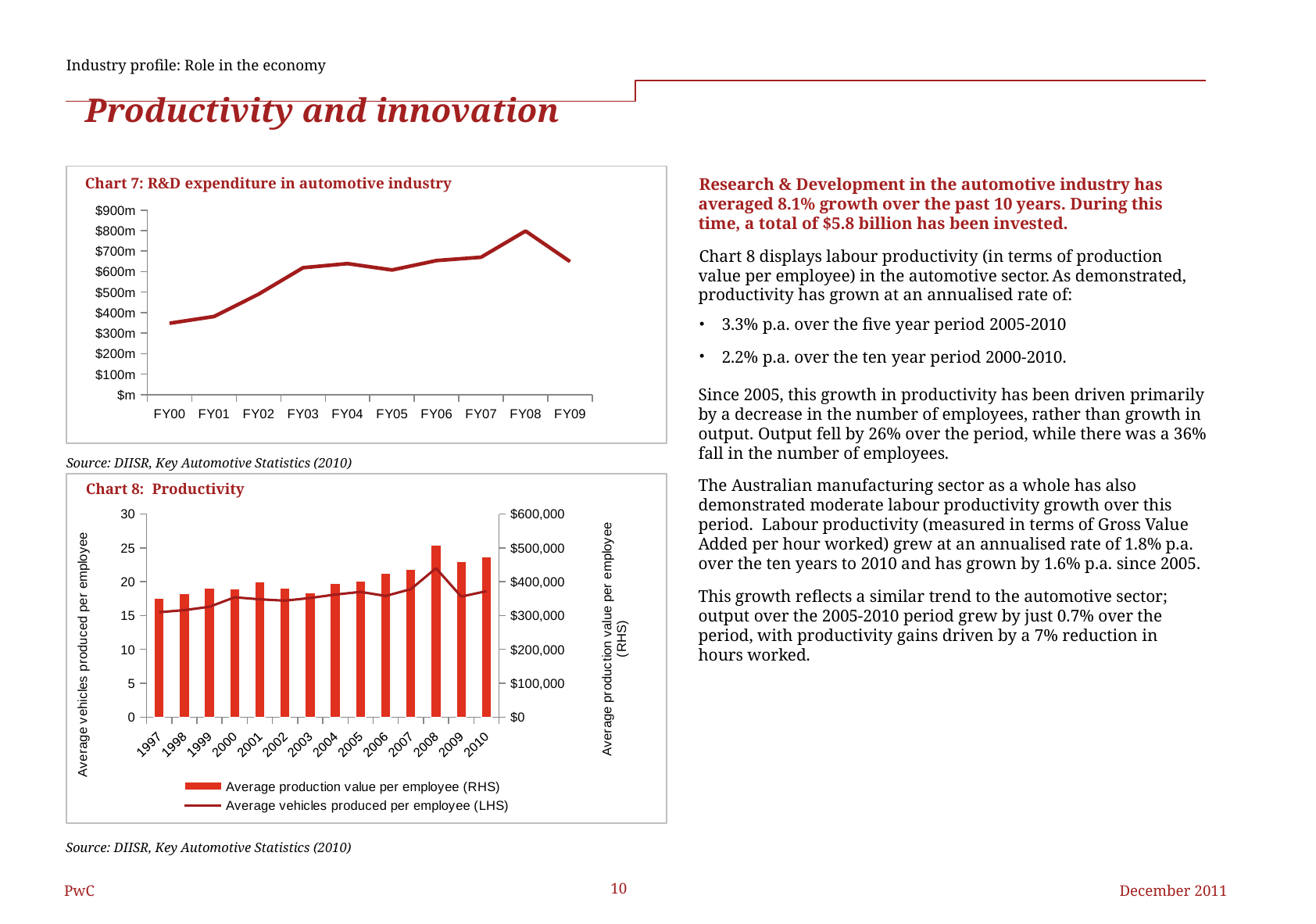
In Chart 7: R&D expenditure in automotive industry, is the value for FY00 greater or less than $400m? less In Chart 7: R&D expenditure in automotive industry, which fiscal year has the highest R&D expenditure? FY08 In Chart 8: Productivity, which year has the highest average production value per employee? 2008 In Chart 8: Productivity, how many series does the legend list? 2 In Chart 8: Productivity, how many years are shown on the x axis? 14 In Chart 7: R&D expenditure in automotive industry, is the value for FY08 greater or less than $700m? greater In Chart 7: R&D expenditure in automotive industry, how many fiscal years are plotted? 10 What kind of chart is Chart 7: R&D expenditure in automotive industry? line chart In Chart 8: Productivity, is the average production value per employee for 1997 greater or less than $400,000? less In Chart 7: R&D expenditure in automotive industry, which is larger, the value for FY08 or FY09? FY08 In Chart 7: R&D expenditure in automotive industry, which fiscal year has the lowest R&D expenditure? FY00